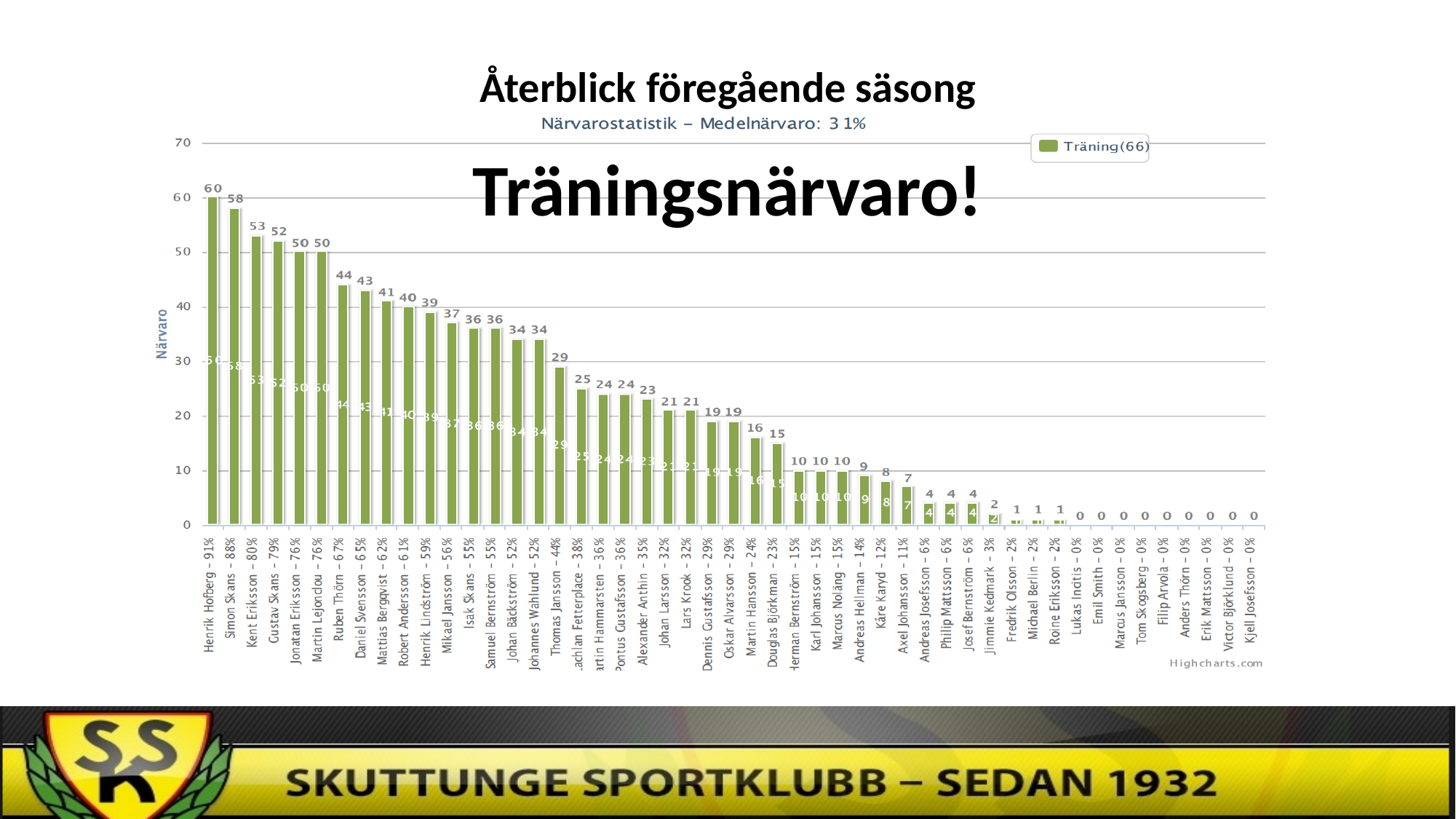
What is the legend entry of the chart? Träning(66) What kind of chart is shown? bar chart What is the difference between the values for Simon Skans and Kent Eriksson? 5 Do the values rise or fall from left to right along the x axis? fall What average attendance (Medelnärvaro) is stated in the chart subtitle? 31% Which is larger, the value for Ruben Thörn or the value for Mikael Jansson? Ruben Thörn How many series does the legend list? 1 Which player has the highest value? Henrik Hofberg What is the value for Thomas Jansson? 29 What is the value for Henrik Hofberg? 60 Is the value for Gustav Skans greater or less than 50? greater What is the value for Kåre Karyd? 8